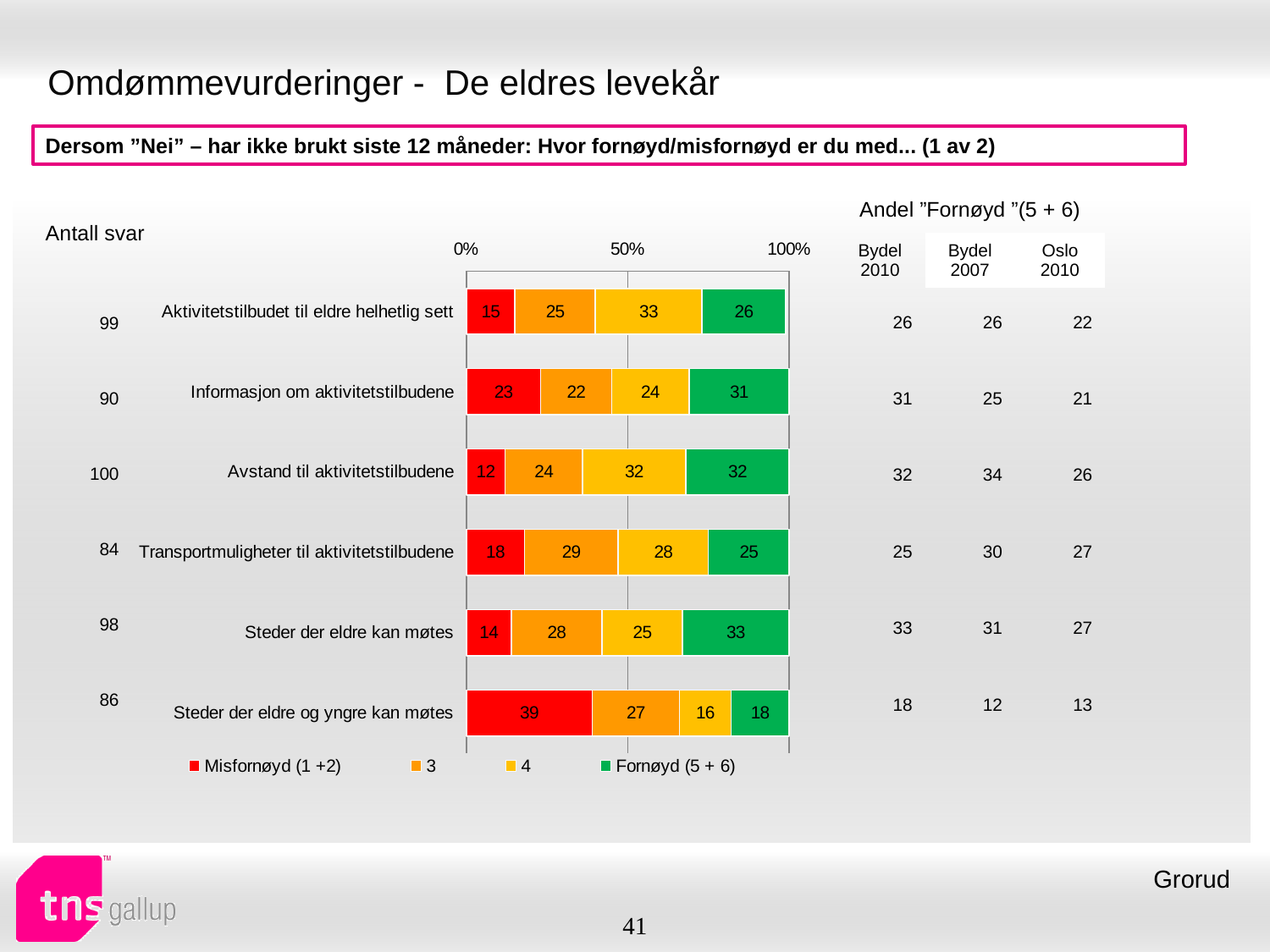
How many series does the legend list? 4 What is the total of the stacked bar for Steder der eldre kan møtes? 100 Which category has the lowest Misfornøyd (1 +2) value? Avstand til aktivitetstilbudene Which category has the highest Misfornøyd (1 +2) value? Steder der eldre og yngre kan møtes Which has the larger Misfornøyd (1 +2) value: Informasjon om aktivitetstilbudene or Transportmuligheter til aktivitetstilbudene? Informasjon om aktivitetstilbudene What is the value of the '4' segment for Avstand til aktivitetstilbudene? 32 What is the value of the Fornøyd (5 + 6) segment for Informasjon om aktivitetstilbudene? 31 For Aktivitetstilbudet til eldre helhetlig sett, what is the difference between the Fornøyd (5 + 6) value and the Misfornøyd (1 +2) value? 11 What is the value of the Misfornøyd (1 +2) segment for Steder der eldre og yngre kan møtes? 39 What kind of chart is shown on the slide? Stacked bar chart How many categories are shown in the chart? 6 Which category has the lowest Fornøyd (5 + 6) value? Steder der eldre og yngre kan møtes